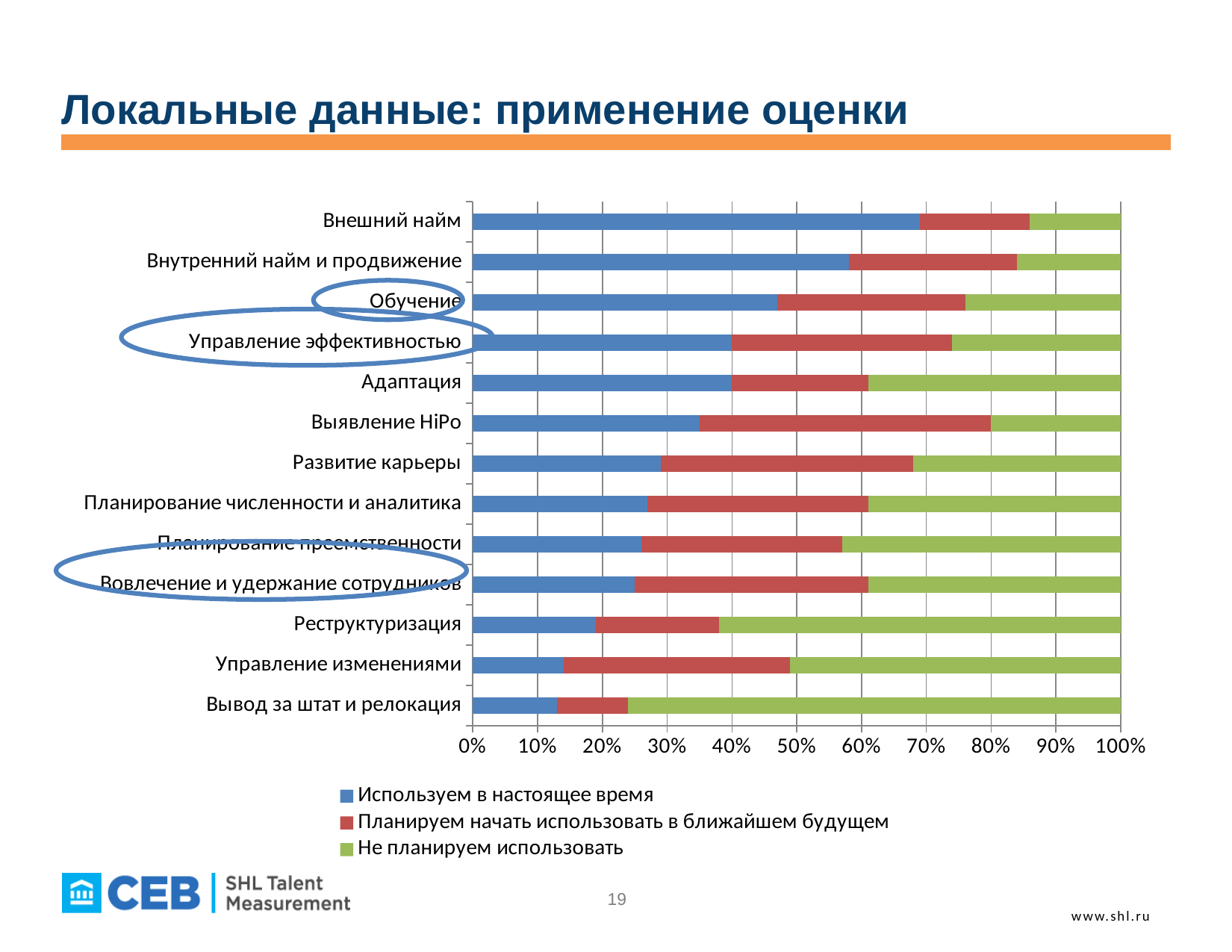
Which category has the largest 'Используем в настоящее время' (blue) segment? Внешний найм What kind of chart is shown on the slide? Stacked bar chart Which has a larger 'Не планируем использовать' segment: Реструктуризация or Вывод за штат и релокация? Вывод за штат и релокация Is the 'Используем в настоящее время' value for Внешний найм greater or less than 60%? greater How many categories (HR areas) are listed on the vertical axis of the chart? 13 What is the title of the slide containing the chart? Локальные данные: применение оценки Which has a larger 'Используем в настоящее время' segment: Внешний найм or Внутренний найм и продвижение? Внешний найм Which category has the largest 'Не планируем использовать' (green) segment? Вывод за штат и релокация Is the 'Используем в настоящее время' value for Вывод за штат и релокация greater or less than 20%? less How many series does the chart legend list? 3 Is the 'Используем в настоящее время' value for Обучение greater or less than 50%? less Moving down the list of categories from Внешний найм to Вывод за штат и релокация, does the 'Используем в настоящее время' segment generally increase or decrease? decrease